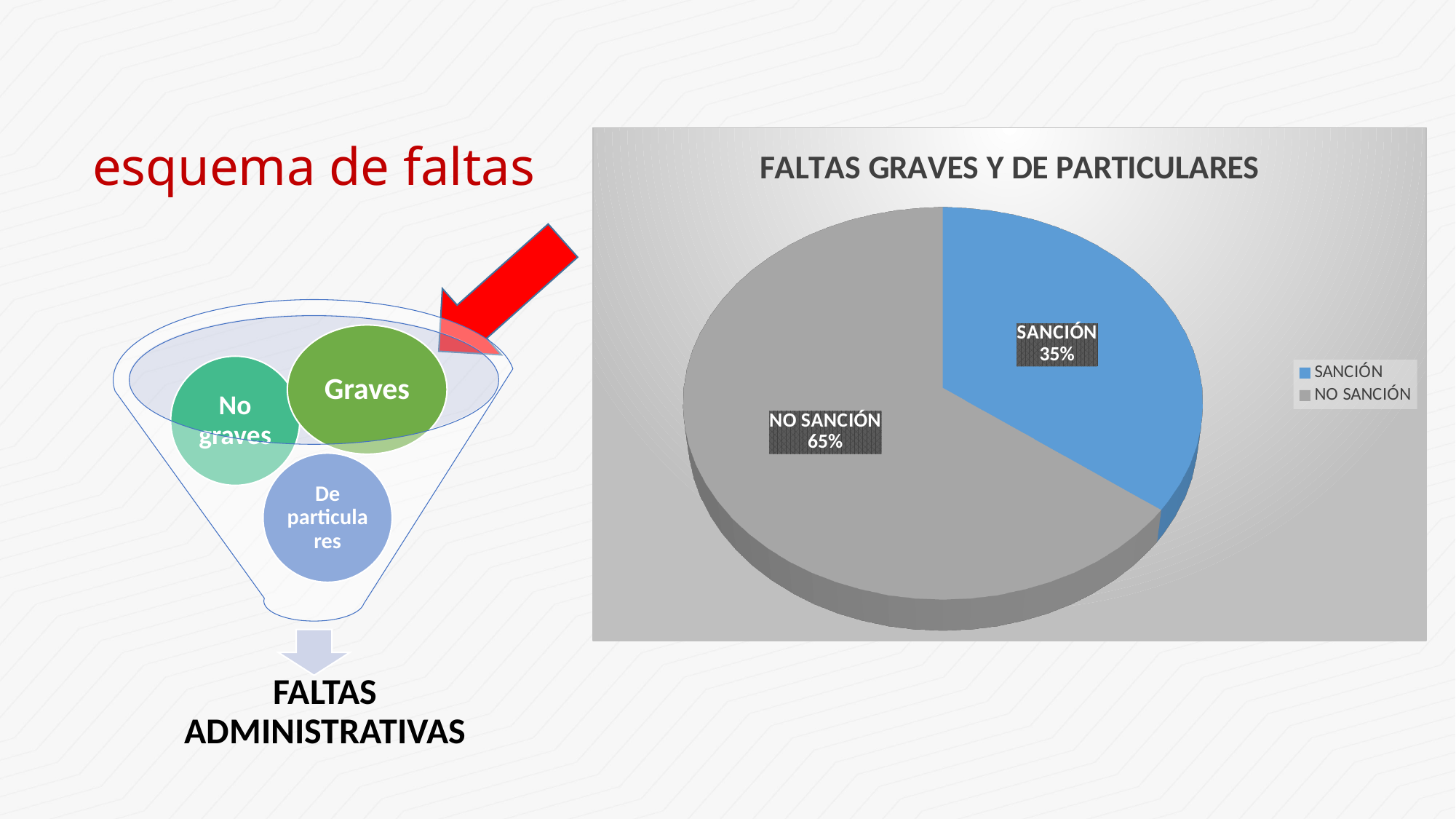
How many slices does the pie chart have? 2 What is the difference in percentage points between NO SANCIÓN and SANCIÓN? 30 What is the title of the pie chart? FALTAS GRAVES Y DE PARTICULARES Which is larger, SANCIÓN or NO SANCIÓN? NO SANCIÓN Which slice of the pie chart is the smallest? SANCIÓN Which slice of the pie chart is the largest? NO SANCIÓN What share of the pie does the SANCIÓN slice represent? 35% What percentage is shown for SANCIÓN? 35% How many entries does the legend list? 2 What colour is the SANCIÓN slice in the pie chart? blue What percentage is shown for NO SANCIÓN? 65% What type of chart is shown on the slide? pie chart